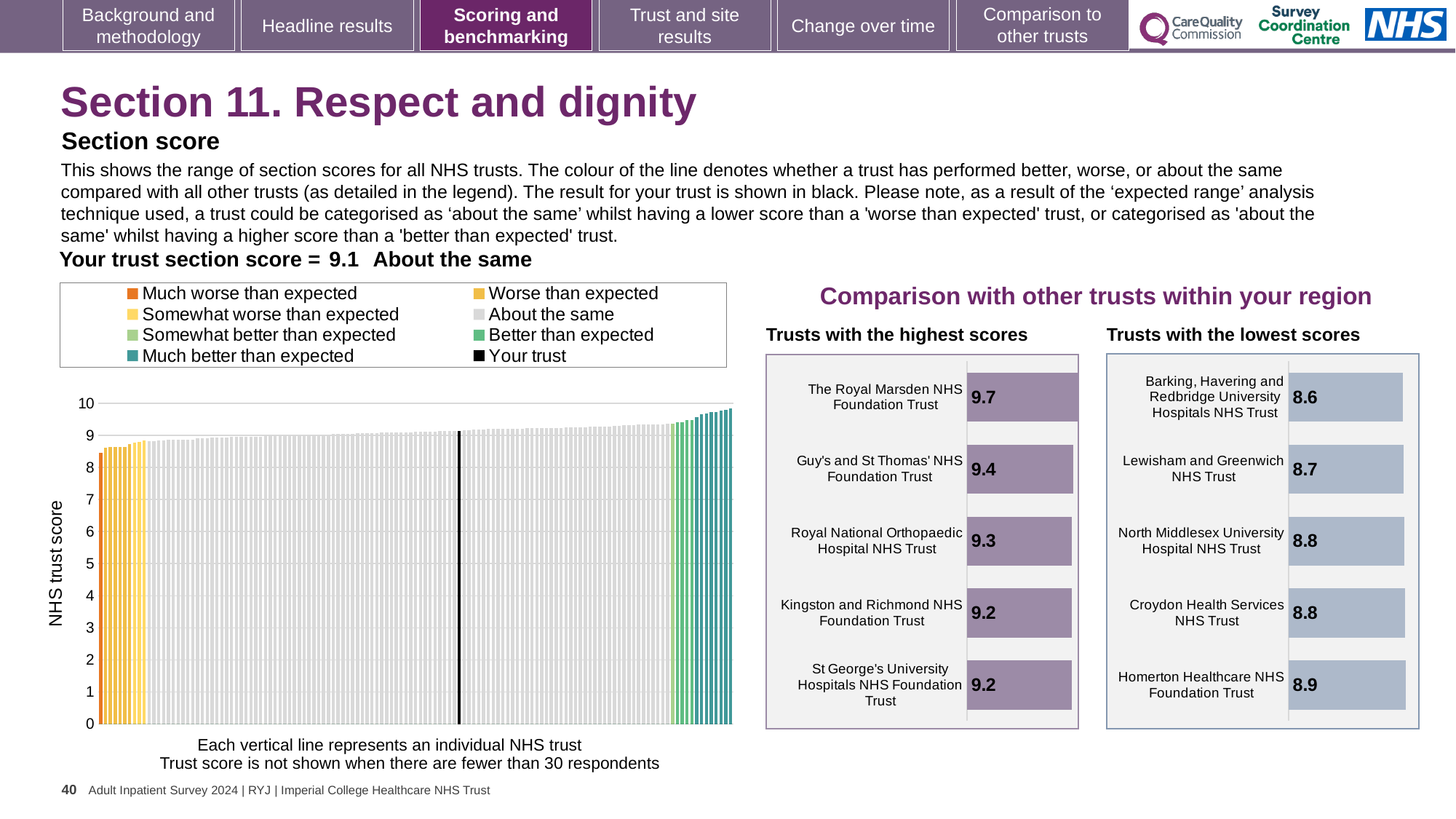
In the 'Trusts with the highest scores' chart, what is the difference between the scores of The Royal Marsden NHS Foundation Trust and Guy's and St Thomas' NHS Foundation Trust? 0.3 In the 'Trusts with the lowest scores' chart, what is the score for Lewisham and Greenwich NHS Trust? 8.7 What kind of chart is the large chart on the left showing NHS trust scores? Bar chart How many entries does the legend of the large chart on the left list? 8 In the 'Trusts with the lowest scores' chart, what is the difference between the scores of Homerton Healthcare NHS Foundation Trust and Barking, Havering and Redbridge University Hospitals NHS Trust? 0.3 In the 'Trusts with the lowest scores' chart, which trust has the lowest score? Barking, Havering and Redbridge University Hospitals NHS Trust How many trusts are shown in the 'Trusts with the highest scores' chart? 5 In the 'Trusts with the lowest scores' chart, which has the higher score: Homerton Healthcare NHS Foundation Trust or Barking, Havering and Redbridge University Hospitals NHS Trust? Homerton Healthcare NHS Foundation Trust In the large chart on the left, do the trust scores rise or fall from left to right? Rise In the 'Trusts with the highest scores' chart, which trust has the highest score? The Royal Marsden NHS Foundation Trust In the 'Trusts with the highest scores' chart, what is the score for The Royal Marsden NHS Foundation Trust? 9.7 In the large chart on the left, what is the section score for your trust (shown in black)? 9.1